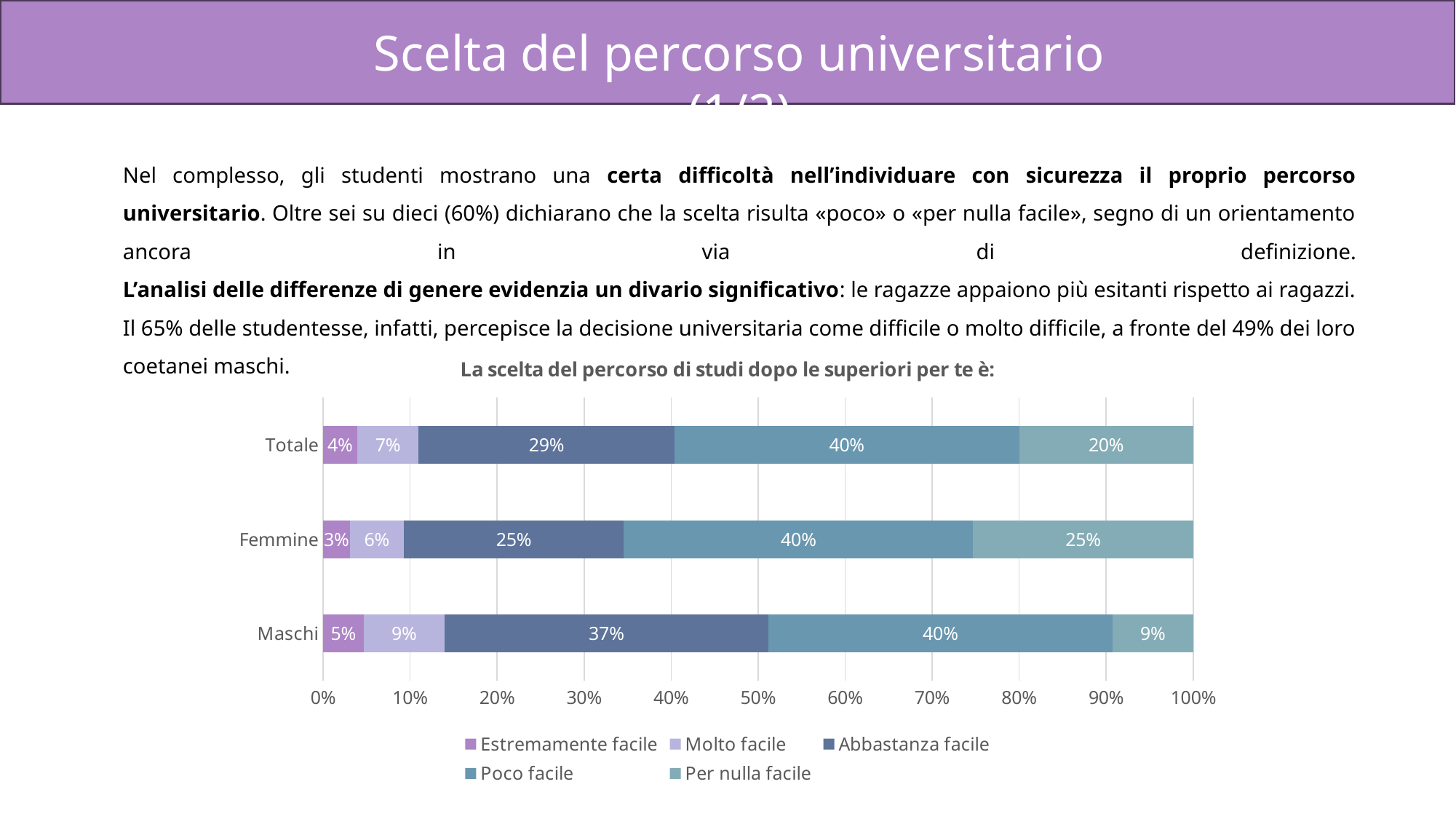
How many series does the legend list? 5 Which category has the highest value for 'Per nulla facile'? Femmine What is the value for 'Estremamente facile' in the Femmine bar? 3% What is the value for 'Abbastanza facile' in the Maschi bar? 37% What is the difference between the 'Per nulla facile' values for Femmine and Maschi? 16% Which is larger: 'Molto facile' for Maschi or 'Molto facile' for Femmine? Maschi What is the value for 'Molto facile' in the Totale bar? 7% Which category has the lowest value for 'Abbastanza facile'? Femmine What kind of chart is shown? Stacked bar chart What is the value for 'Per nulla facile' in the Femmine bar? 25% What is the title of the chart? La scelta del percorso di studi dopo le superiori per te è: How many categories are shown on the y axis? 3